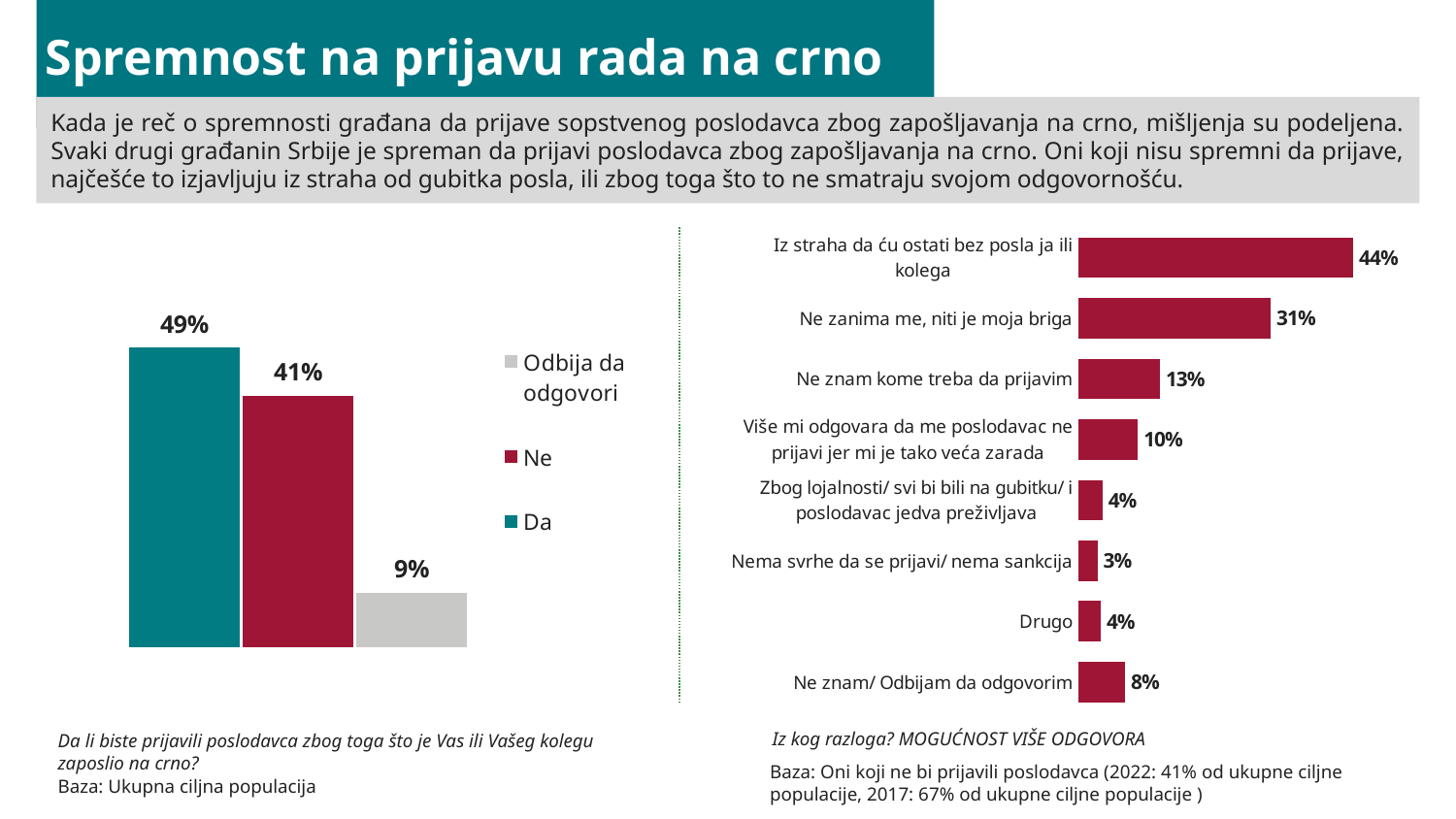
In the right chart, what is the value for "Iz straha da ću ostati bez posla ja ili kolega"? 44% In the right chart, what is the difference between "Iz straha da ću ostati bez posla ja ili kolega" and "Ne zanima me, niti je moja briga"? 13% In the left chart, what is the value for "Odbija da odgovori"? 9% In the left chart, what is the value for "Ne"? 41% In the right chart, how many categories are shown? 8 In the left chart, what is the difference between the values for "Da" and "Ne"? 8% In the left chart, how many entries does the legend list? 3 In the right chart, which category has the lowest value? Nema svrhe da se prijavi/ nema sankcija In the left chart, what is the value for "Da"? 49% In the right chart, which is larger: "Ne znam kome treba da prijavim" or "Ne znam/ Odbijam da odgovorim"? Ne znam kome treba da prijavim What kind of chart is the right chart? Bar chart In the right chart, what is the value for "Ne zanima me, niti je moja briga"? 31%